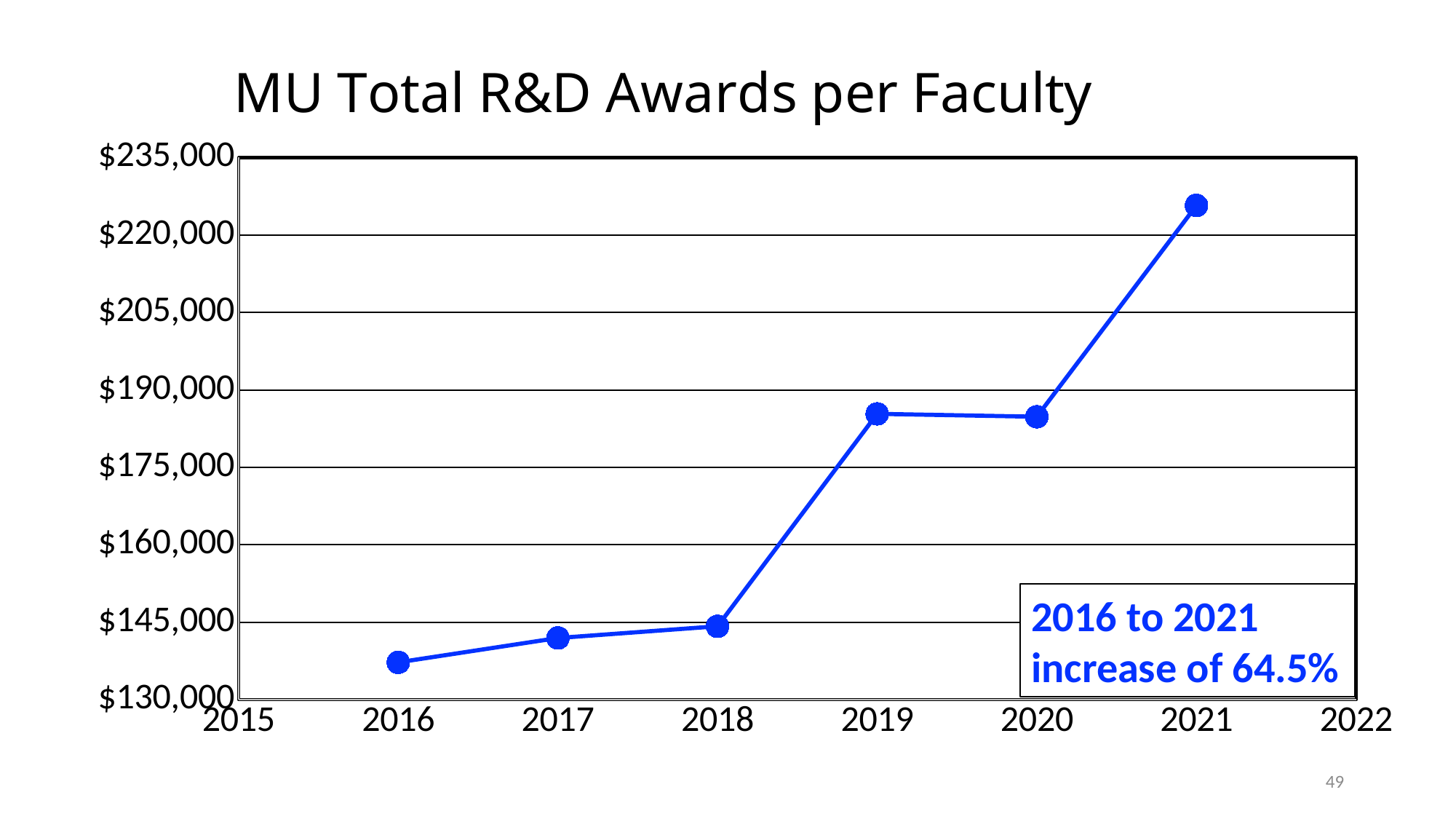
According to the annotation on the chart, what is the percentage increase from 2016 to 2021? 64.5% Do the values generally rise or fall from 2016 to 2021? rise Is the value for 2021 greater or less than $220,000? greater Is the value for 2019 greater or less than $190,000? less Which year has the highest R&D awards per faculty? 2021 Is the value for 2019 greater or less than $175,000? greater What kind of chart is shown on the slide? line chart What is the title of the chart? MU Total R&D Awards per Faculty Which year has the larger value, 2018 or 2019? 2019 Which year has the lowest R&D awards per faculty? 2016 How many data points are plotted on the line? 6